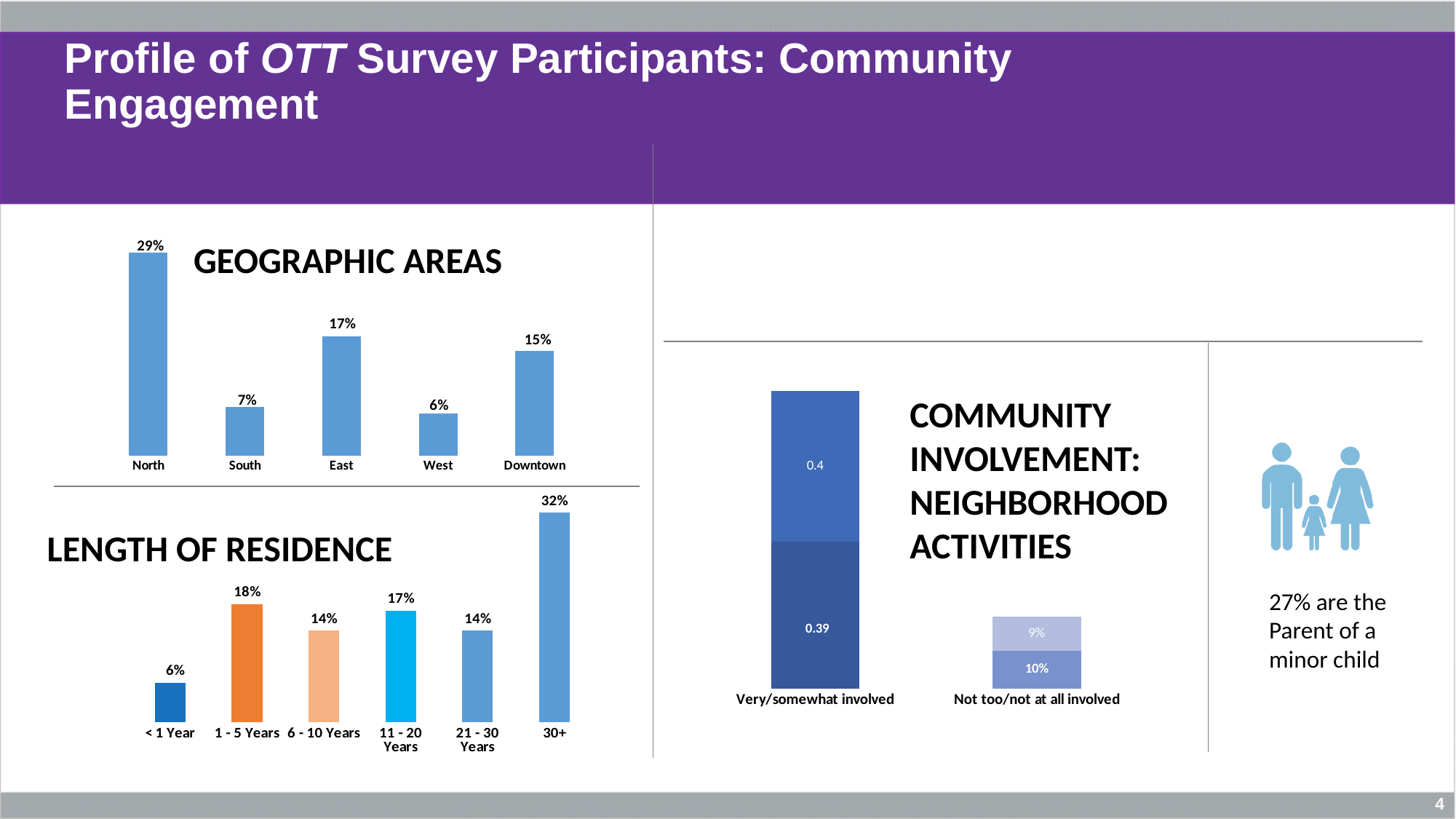
In the Length of Residence chart, which is larger: 1 - 5 Years or 11 - 20 Years? 1 - 5 Years In the Geographic Areas chart, which area has the lowest percentage? West In the Length of Residence chart, how many categories are shown? 6 In the Length of Residence chart, what percentage of participants have lived there 30+ years? 32% In the Geographic Areas chart, how many areas are shown? 5 What kind of chart is the Community Involvement: Neighborhood Activities chart? Stacked bar chart In the Geographic Areas chart, what percentage of participants are from the North? 29% In the Geographic Areas chart, what is the difference between East and Downtown? 2% In the Community Involvement: Neighborhood Activities chart, what is the total of the Not too/not at all involved bar? 19% In the Length of Residence chart, which category has the highest percentage? 30+ In the Length of Residence chart, what is the difference between 30+ and < 1 Year? 26% In the Community Involvement: Neighborhood Activities chart, what is the value of the top segment of the Very/somewhat involved bar? 0.4